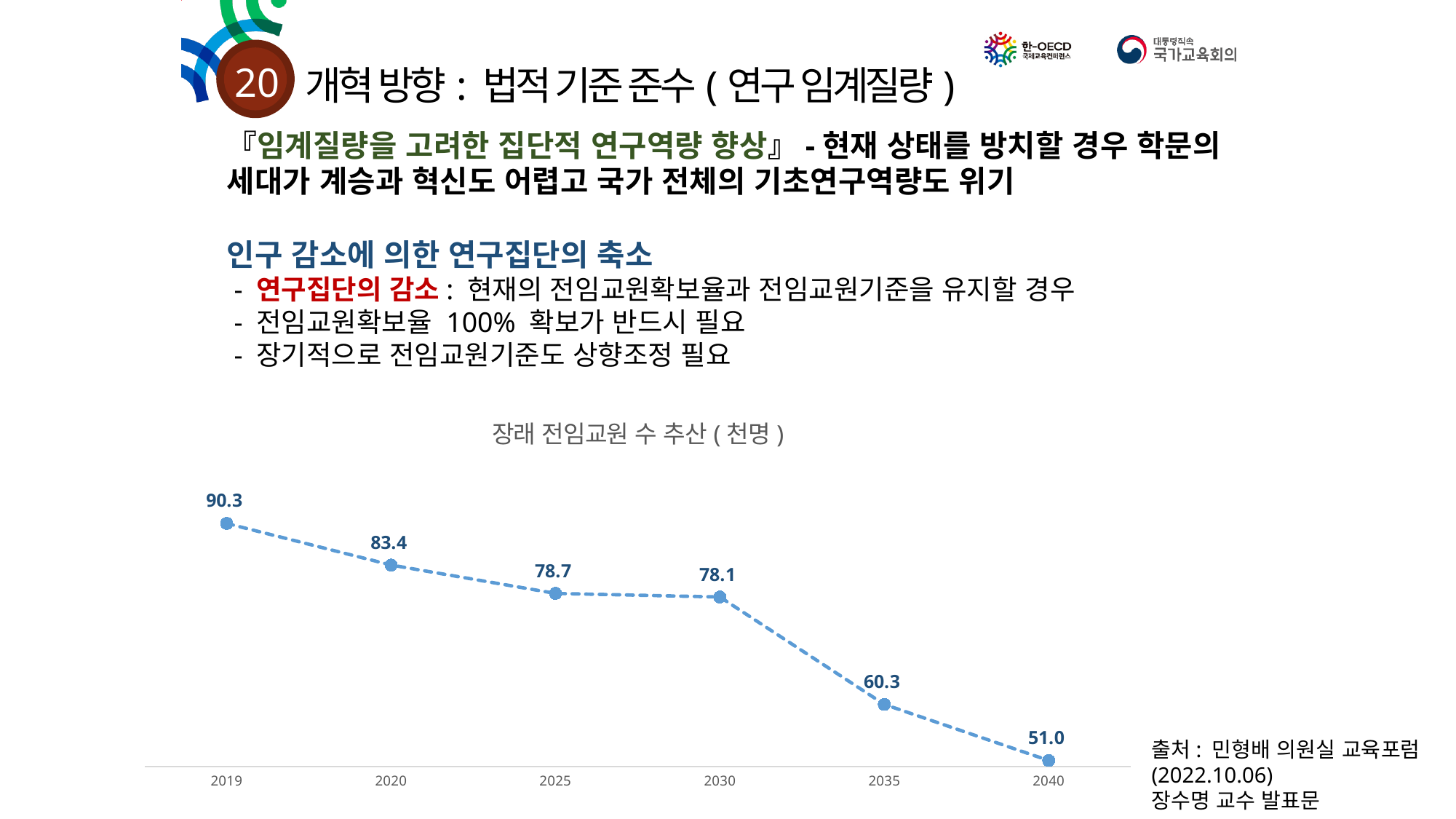
What is the projected number of full-time faculty (천명) for 2019? 90.3 Which is larger, the value for 2020 or the value for 2025? 2020 What is the value shown for 2035? 60.3 Which year has the lowest value on the chart? 2040 What is the difference between the values for 2019 and 2040? 39.3 How many data points are plotted on the chart? 6 What is the value shown for 2030? 78.1 What kind of chart is shown on the slide? Line chart Which year has the highest value on the chart? 2019 Do the values rise or fall from 2019 to 2040? Fall What is the value shown for 2040? 51.0 What is the difference between the values for 2030 and 2035? 17.8